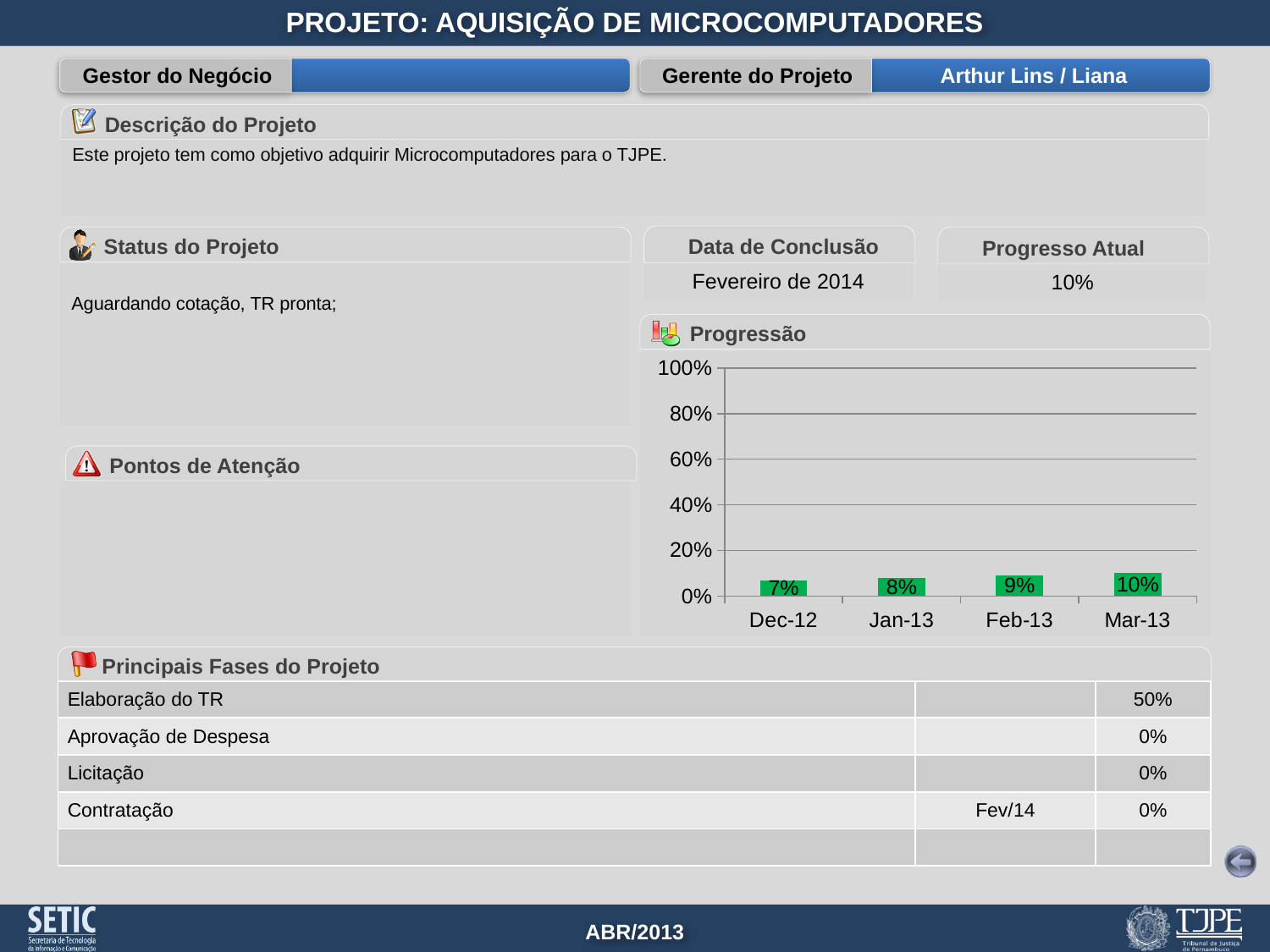
What is the value for Mar-13 in the Progressão chart? 10% What is the value for Feb-13 in the Progressão chart? 9% Which is larger in the Progressão chart, the value for Jan-13 or the value for Feb-13? Feb-13 What is the value for Dec-12 in the Progressão chart? 7% Which month has the highest value in the Progressão chart? Mar-13 Which month has the lowest value in the Progressão chart? Dec-12 How many months are shown on the x axis of the Progressão chart? 4 Do the values in the Progressão chart rise or fall from Dec-12 to Mar-13? rise What is the difference between the values for Mar-13 and Dec-12 in the Progressão chart? 3% What is the value for Jan-13 in the Progressão chart? 8% Is the value for Mar-13 in the Progressão chart greater or less than 20%? less What kind of chart is the Progressão chart? bar chart